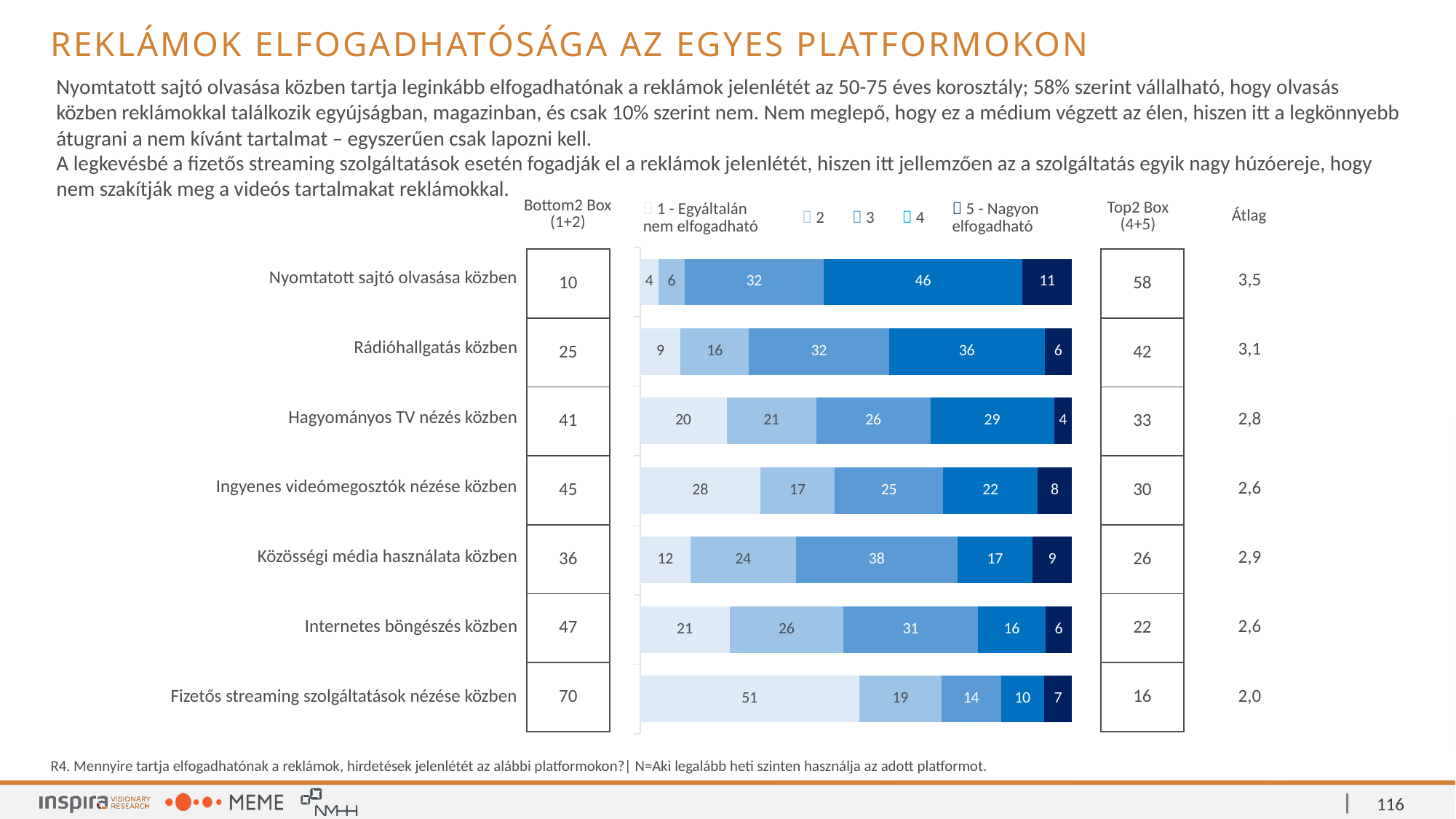
What is the value of the "5 - Nagyon elfogadható" segment for "Nyomtatott sajtó olvasása közben"? 11 What is the value of the "1 - Egyáltalán nem elfogadható" segment for "Fizetős streaming szolgáltatások nézése közben"? 51 How many categories (platforms) are shown in the chart? 7 What is the total of the printed segment values for "Hagyományos TV nézés közben"? 100 What is the Átlag value for "Fizetős streaming szolgáltatások nézése közben"? 2,0 Which category has the largest "4" segment? Nyomtatott sajtó olvasása közben How many series does the legend list? 5 What kind of chart is shown on the slide? Stacked bar chart Which category has the smallest "5 - Nagyon elfogadható" segment? Hagyományos TV nézés közben What is the difference between the "3" segment for "Közösségi média használata közben" and the "3" segment for "Internetes böngészés közben"? 7 Which has a larger "2" segment: "Rádióhallgatás közben" or "Hagyományos TV nézés közben"? Hagyományos TV nézés közben What is the Top2 Box (4+5) value for "Rádióhallgatás közben"? 42